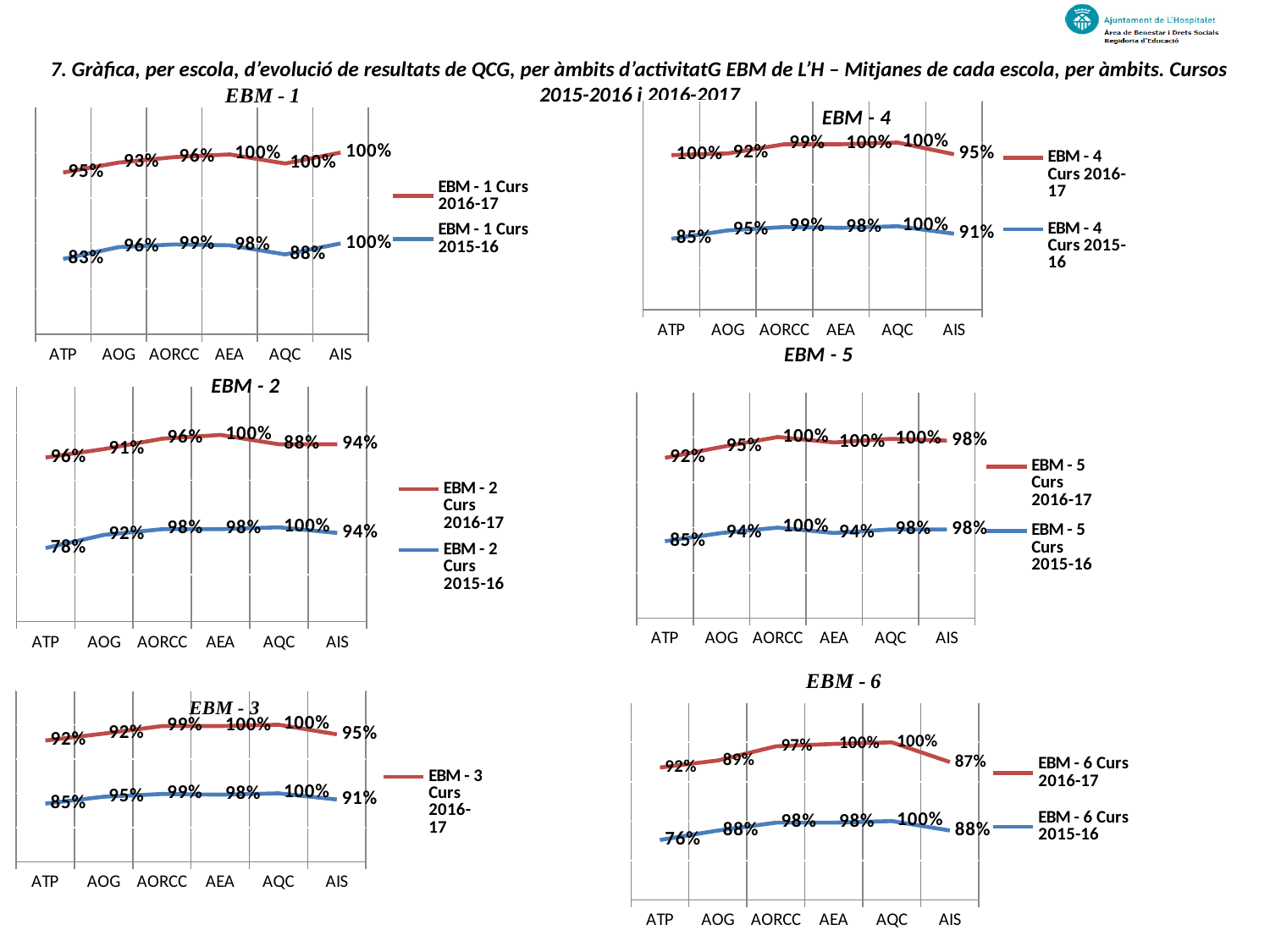
In the EBM - 6 chart, what is the value for ATP in the EBM - 6 Curs 2015-16 series? 76% In the EBM - 5 chart, what is the difference between the 2016-17 and 2015-16 values for AEA? 6% In the EBM - 2 chart, which is larger for AQC: the Curs 2016-17 value or the Curs 2015-16 value? Curs 2015-16 How many categories are shown on the x axis of the EBM - 3 chart? 6 In the EBM - 1 chart, what is the difference between the 2016-17 and 2015-16 values for ATP? 12% In the EBM - 6 chart, which category has the lowest value in the EBM - 6 Curs 2016-17 series? AIS How many series does the legend of the EBM - 5 chart list? 2 In the EBM - 1 chart, what is the value for ATP in the EBM - 1 Curs 2015-16 series? 83% In the EBM - 2 chart, what is the value for AQC in the EBM - 2 Curs 2016-17 series? 88% What type of chart is the EBM - 4 chart? Line chart In the EBM - 2 chart, which category has the lowest value in the EBM - 2 Curs 2015-16 series? ATP In the EBM - 4 chart, which is larger for AOG: the Curs 2016-17 value or the Curs 2015-16 value? Curs 2015-16